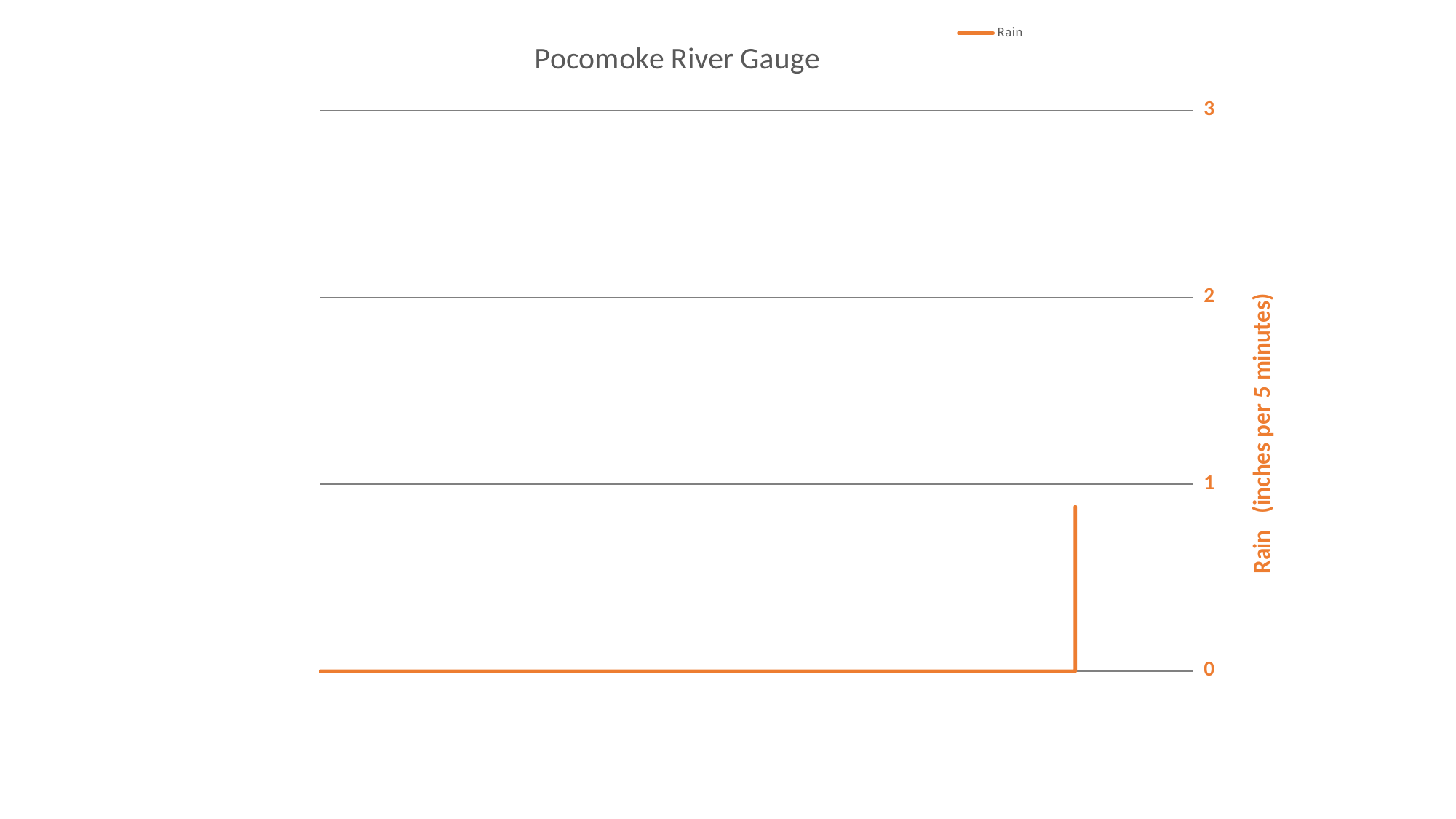
Is the peak value of the Rain line greater or less than 2? less Is the peak value of the Rain line greater or less than 1? less What is the highest value shown on the vertical axis? 3 What is the title of the chart? Pocomoke River Gauge Does the Rain line rise or fall at the right end of the chart? rise How many series does the legend list? 1 What kind of chart is shown on the slide? line chart What is the label on the vertical axis? Rain (inches per 5 minutes)